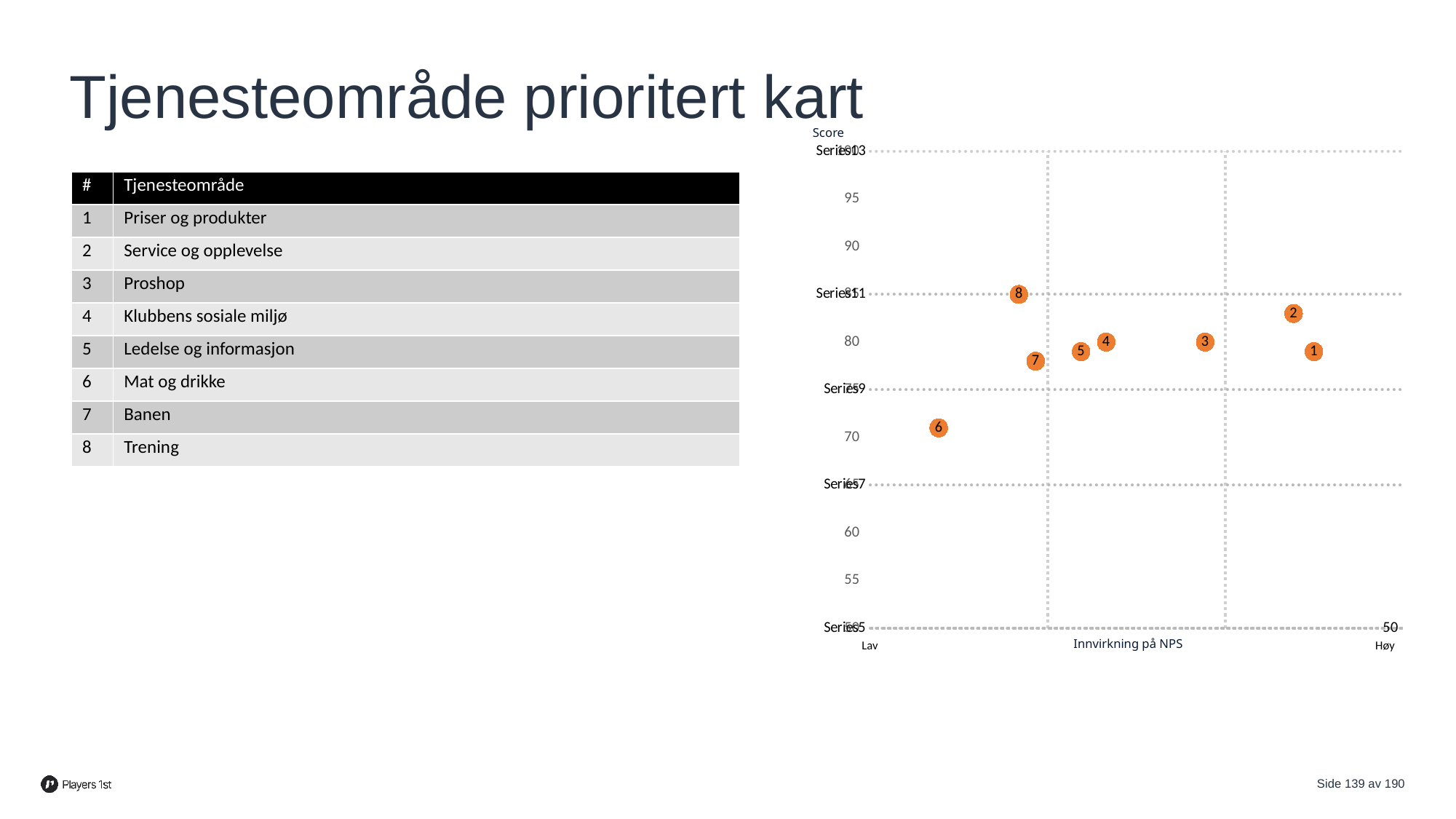
Is the Score for point 7 greater or less than 80? less Is the Score for point 2 greater or less than 80? greater How many numbered points are plotted on the chart? 8 Which numbered point has the lowest Score on the chart? 6 What is the title of the vertical axis of the chart? Score Which numbered point has the highest Score on the chart? 8 Is the Score for point 6 greater or less than 75? less Which numbered point is furthest to the left on the Innvirkning på NPS axis? 6 What is the title of the horizontal axis of the chart? Innvirkning på NPS What kind of chart is shown on the slide? scatter chart Which has the higher Score, point 8 or point 6? 8